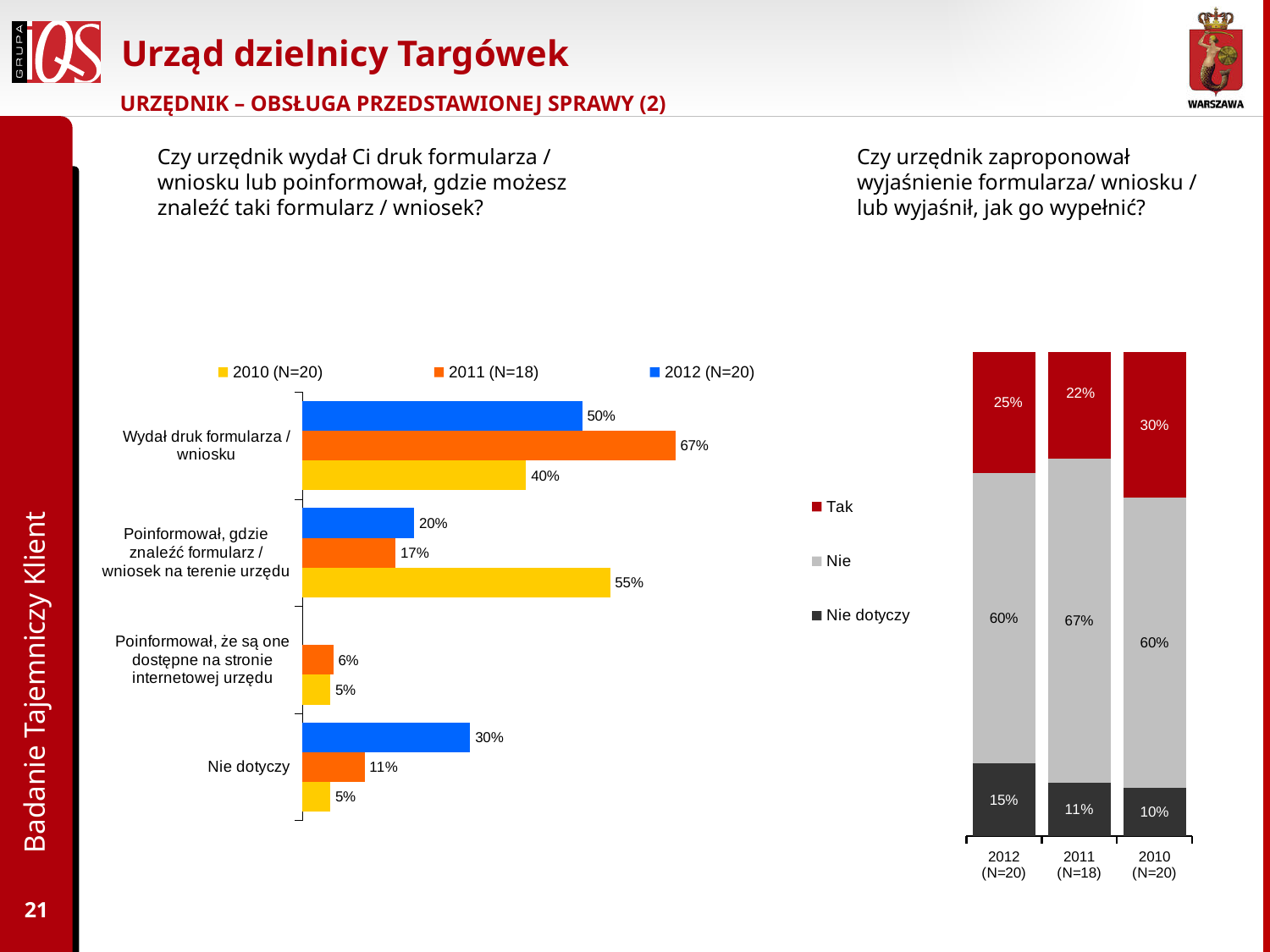
In the left chart, what is the difference between the 2010 and 2012 values for 'Poinformował, gdzie znaleźć formularz / wniosek na terenie urzędu'? 35 percentage points In the right chart, is the 'Tak' share larger in 2012 or in 2011? 2012 In the left chart, which year has the highest value for 'Wydał druk formularza / wniosku'? 2011 (N=18) In the right chart, what is the 'Tak' share for 2010 (N=20)? 30% In the right chart, what is the 'Nie' share for 2011 (N=18)? 67% In the left chart, what is the value for 'Wydał druk formularza / wniosku' in 2011 (N=18)? 67% In the left chart, how many series does the legend list? 3 In the right chart, how many bars (years) are shown? 3 In the left chart, what is the value for 'Poinformował, gdzie znaleźć formularz / wniosek na terenie urzędu' in 2010 (N=20)? 55% What type of chart is the left chart? Bar chart In the left chart, what is the value for 'Nie dotyczy' in 2012 (N=20)? 30% In the right chart, which year has the lowest 'Nie dotyczy' share? 2010 (N=20)